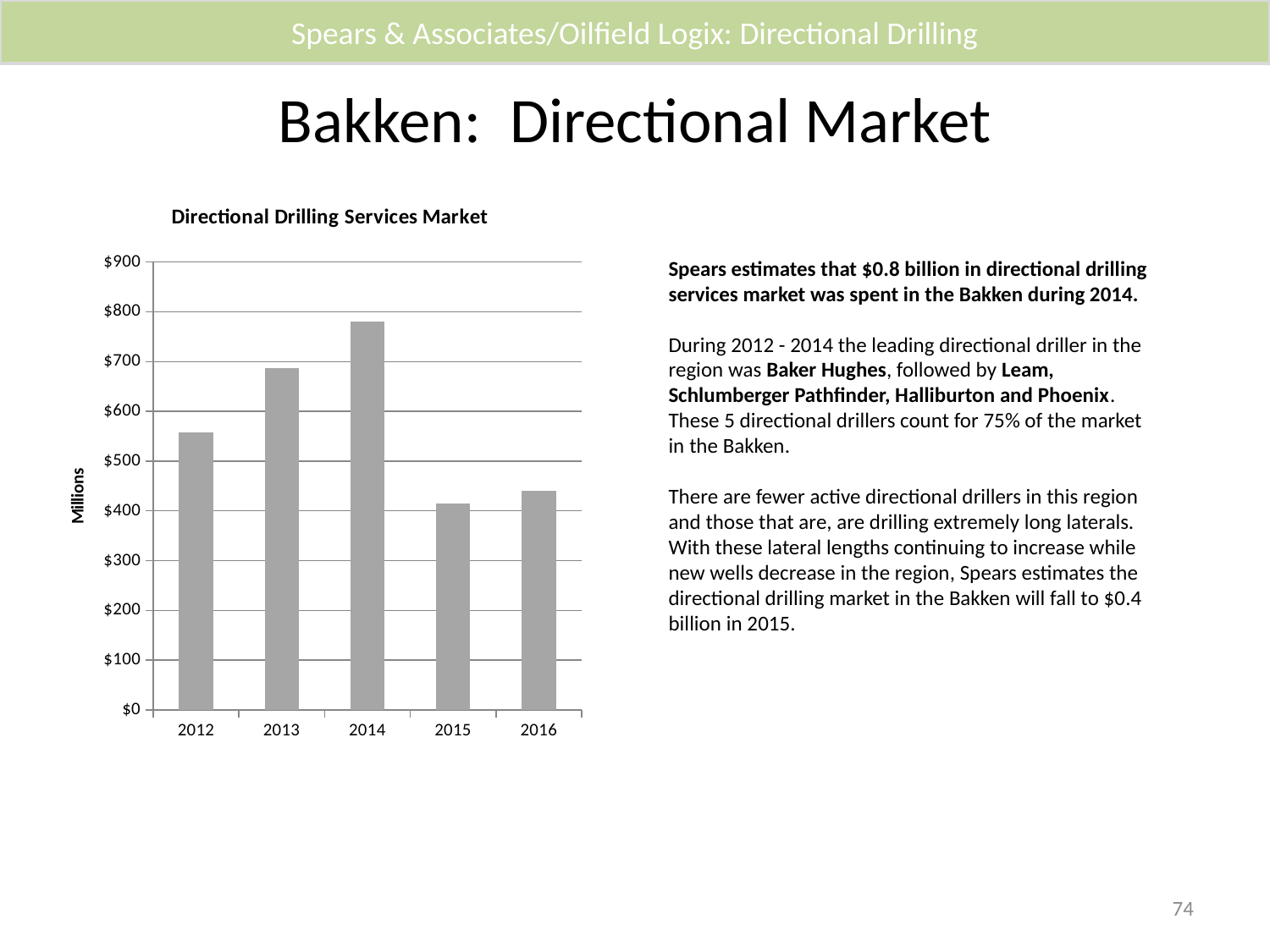
Is the value for 2016 greater or less than $500? less Which year has the lowest value in the chart? 2015 Is the value for 2015 greater or less than $500? less Is the value for 2014 greater or less than $700? greater Which year has the larger value, 2013 or 2014? 2014 What is the label on the vertical axis of the chart? Millions What is the title of the chart? Directional Drilling Services Market How many years are shown on the x axis of the chart? 5 Which year has the highest value in the chart? 2014 What type of chart is shown on the slide? Bar chart